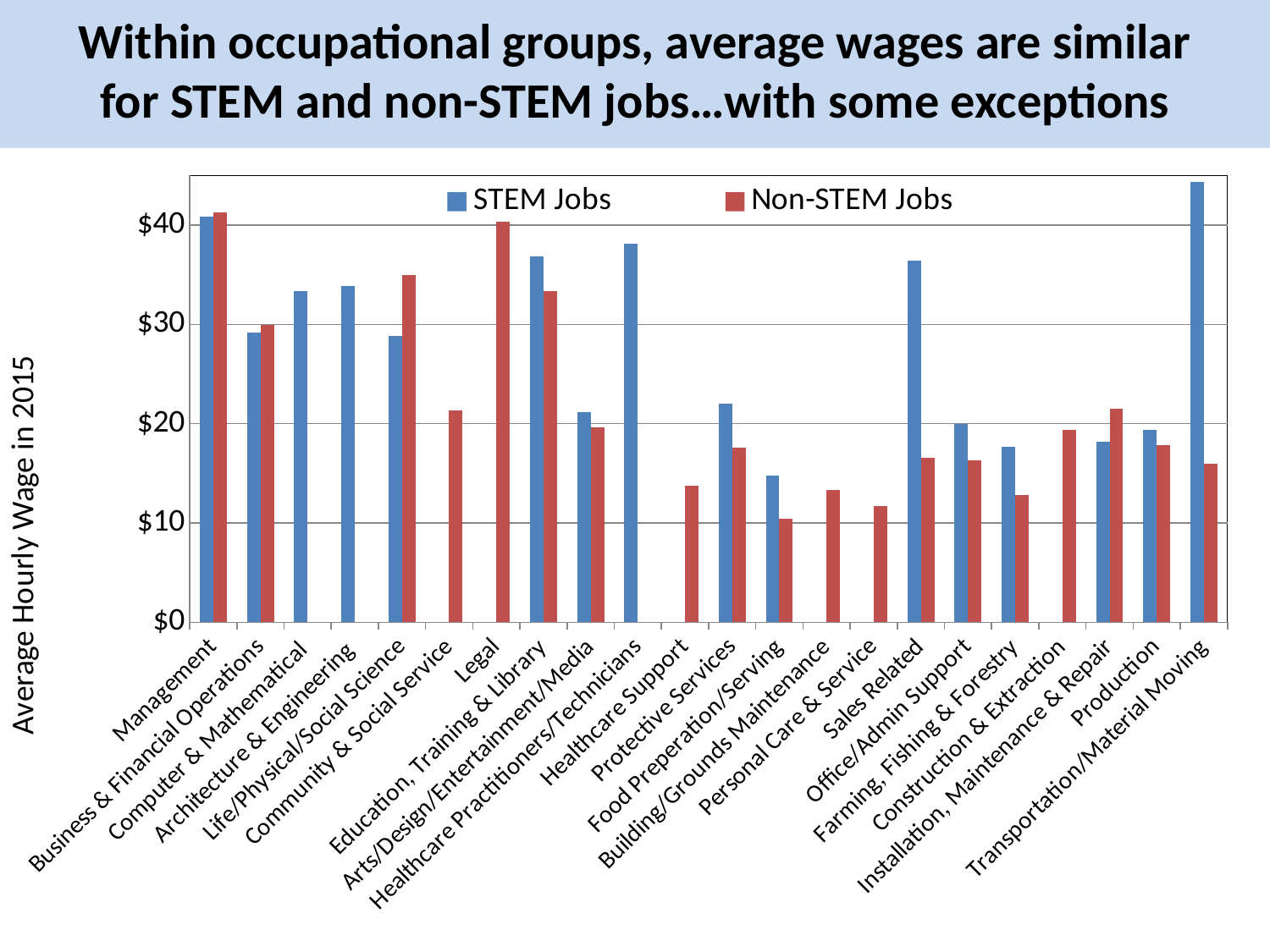
Is the Non-STEM Jobs value for Healthcare Support greater or less than $20? less Is the STEM Jobs value for Sales Related greater or less than $30? greater What kind of chart is shown on the slide? bar chart For Sales Related, which is larger: the STEM Jobs wage or the Non-STEM Jobs wage? STEM Jobs Is the Non-STEM Jobs value for Legal greater or less than $30? greater How many series does the legend list? 2 For Life/Physical/Social Science, which is larger: the STEM Jobs wage or the Non-STEM Jobs wage? Non-STEM Jobs What is the label of the y axis? Average Hourly Wage in 2015 Which occupational group has the highest STEM Jobs average hourly wage? Transportation/Material Moving Which colour represents Non-STEM Jobs in the chart? red Which occupational group has the lowest STEM Jobs average hourly wage? Food Preperation/Serving How many occupational groups are shown on the x axis? 22